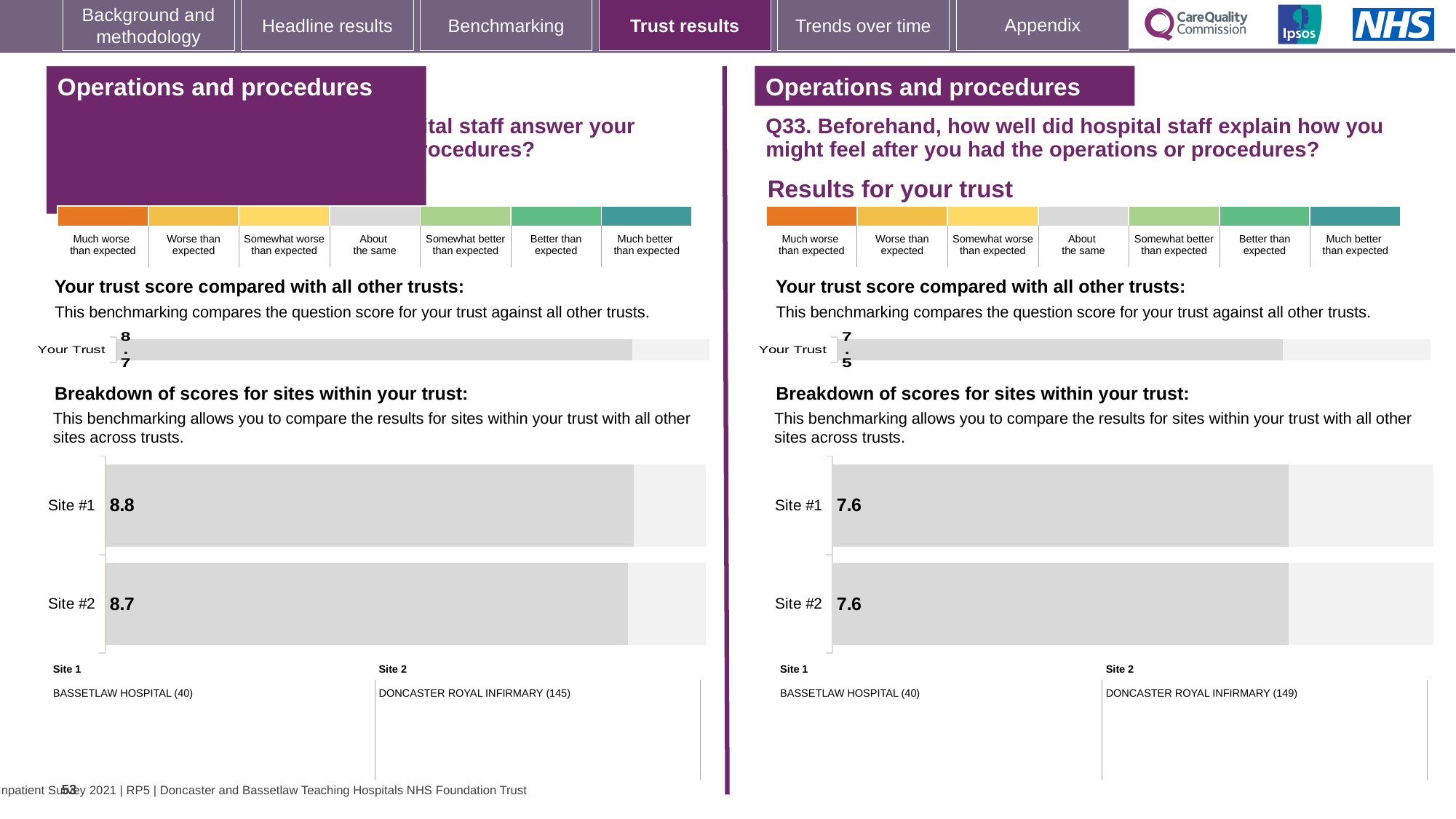
On the left-hand site breakdown chart, what is the score for Site #1? 8.8 On the left-hand site breakdown chart, which site has the higher score? Site #1 On the right-hand side for Q33, what is the 'Your Trust' score? 7.5 On the right-hand chart for Q33, how many sites are shown? 2 On the right-hand side for Q33, which hospital is listed as Site 2? DONCASTER ROYAL INFIRMARY (149) On the left-hand side, which hospital is listed as Site 1? BASSETLAW HOSPITAL (40) On the right-hand chart for Q33, what is the score for Site #2? 7.6 On the left-hand side, what is the 'Your Trust' score? 8.7 On the left-hand site breakdown chart, what is the score for Site #2? 8.7 On the left-hand site breakdown chart, what is the difference between the Site #1 and Site #2 scores? 0.1 On the right-hand chart for Q33, what is the score for Site #1? 7.6 What type of chart is used for the site breakdown on the right-hand side for Q33? Bar chart